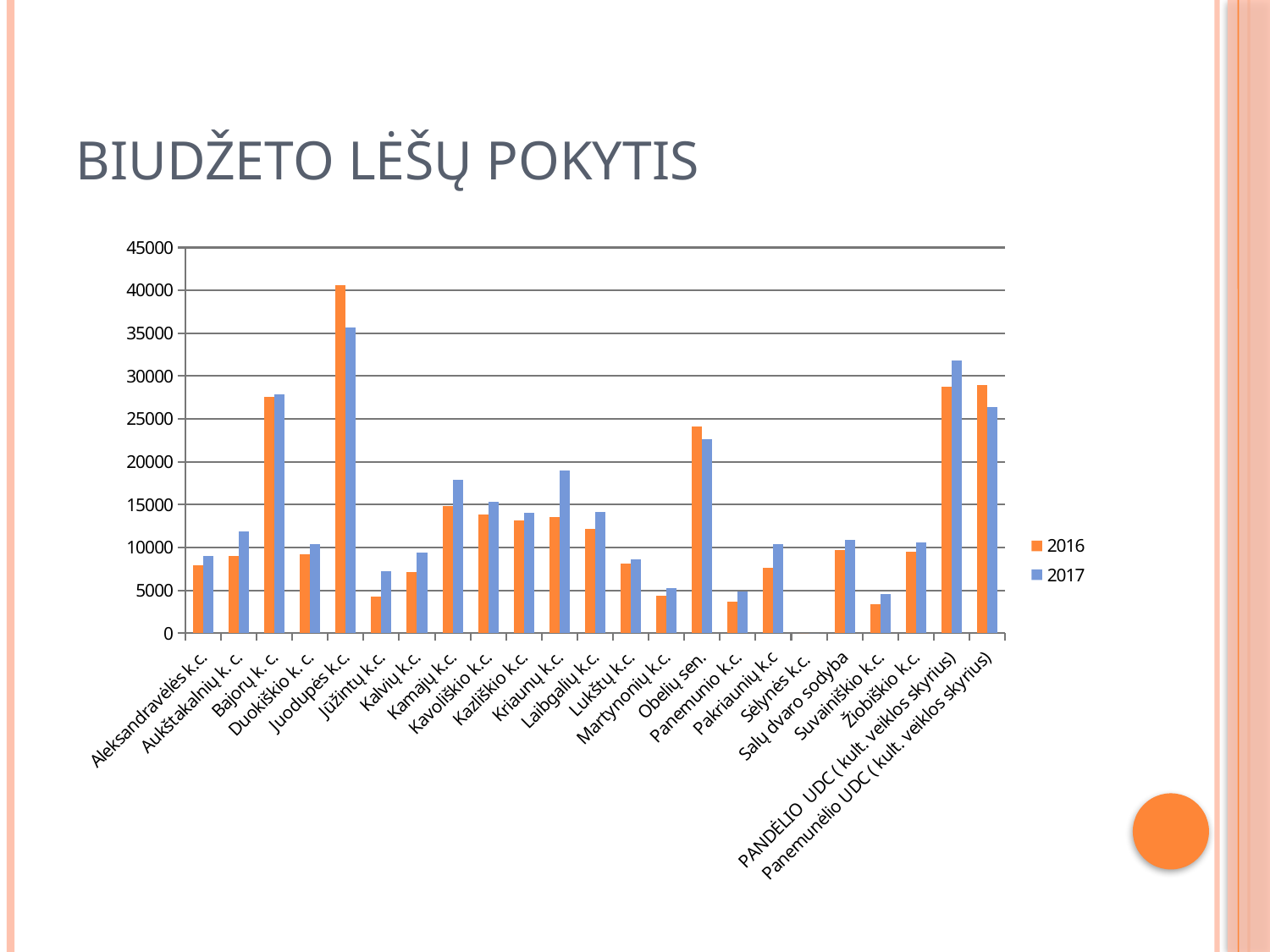
Is the 2016 value for Bajorų k. c. greater or less than 25000? greater Which colour represents the 2017 series in the chart? Blue Which category has the highest value for 2016? Juodupės k.c. Is the 2016 value for Juodupės k.c. greater or less than 35000? greater How many series does the legend list? 2 What kind of chart is shown on the slide? Bar chart Is the 2017 value for PANDĖLIO UDC (kult. veiklos skyrius) greater or less than 30000? greater What is the title of the slide with the chart? BIUDŽETO LĖŠŲ POKYTIS For Kriaunų k.c., which year has the larger value, 2016 or 2017? 2017 Which category has the highest value for 2017? Juodupės k.c. For Obelių sen., which year has the larger value, 2016 or 2017? 2016